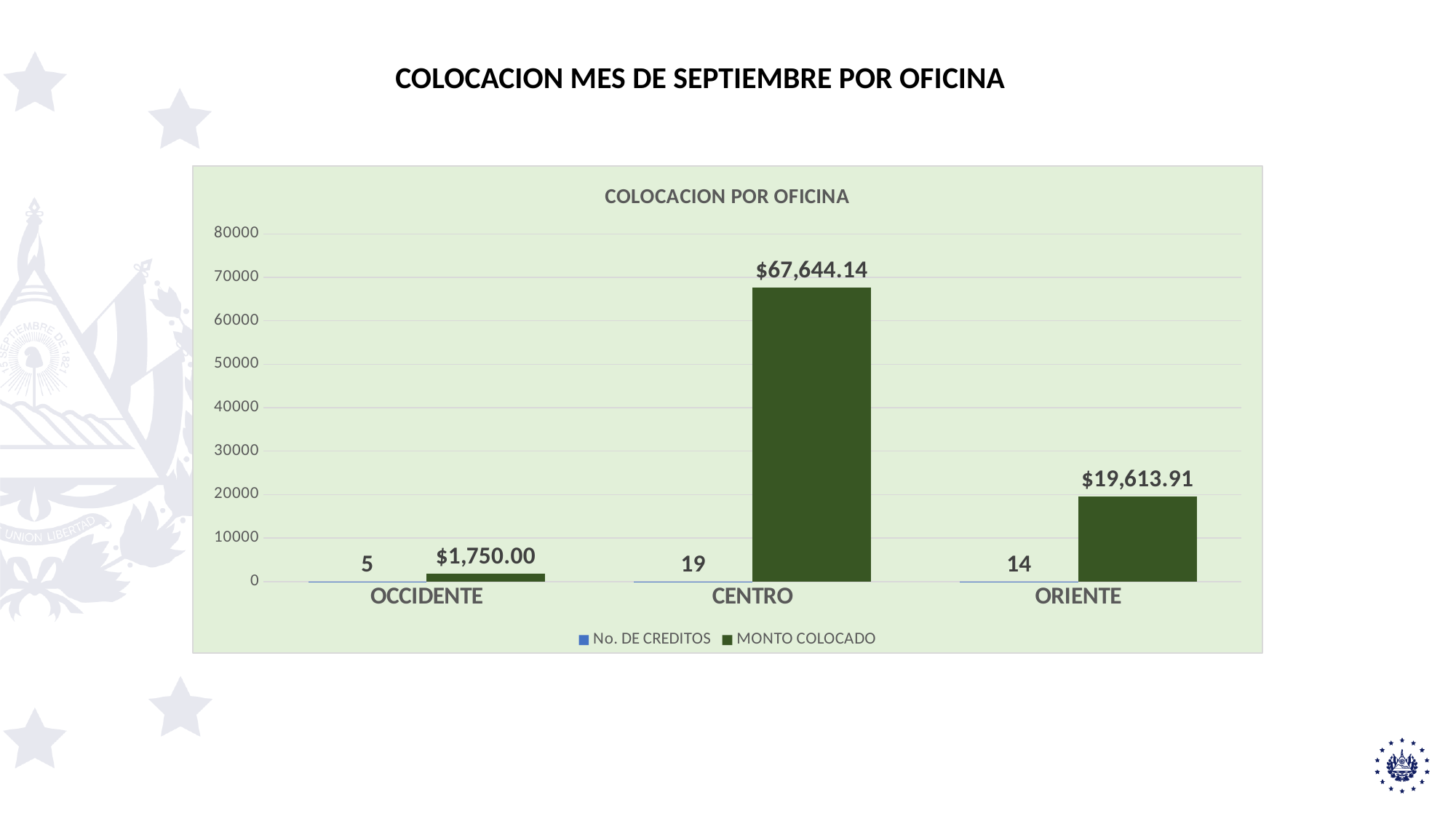
What is the MONTO COLOCADO value for OCCIDENTE? $1,750.00 How many offices are shown on the x axis? 3 Which office has the lowest No. DE CREDITOS? OCCIDENTE What is the difference in MONTO COLOCADO between CENTRO and ORIENTE? $48,030.23 How many series does the legend list? 2 What is the No. DE CREDITOS value for ORIENTE? 14 What type of chart is shown? Bar chart Which office has the highest MONTO COLOCADO? CENTRO Which has a larger No. DE CREDITOS, CENTRO or ORIENTE? CENTRO What is the No. DE CREDITOS value for CENTRO? 19 What is the MONTO COLOCADO value for ORIENTE? $19,613.91 What is the MONTO COLOCADO value for CENTRO? $67,644.14